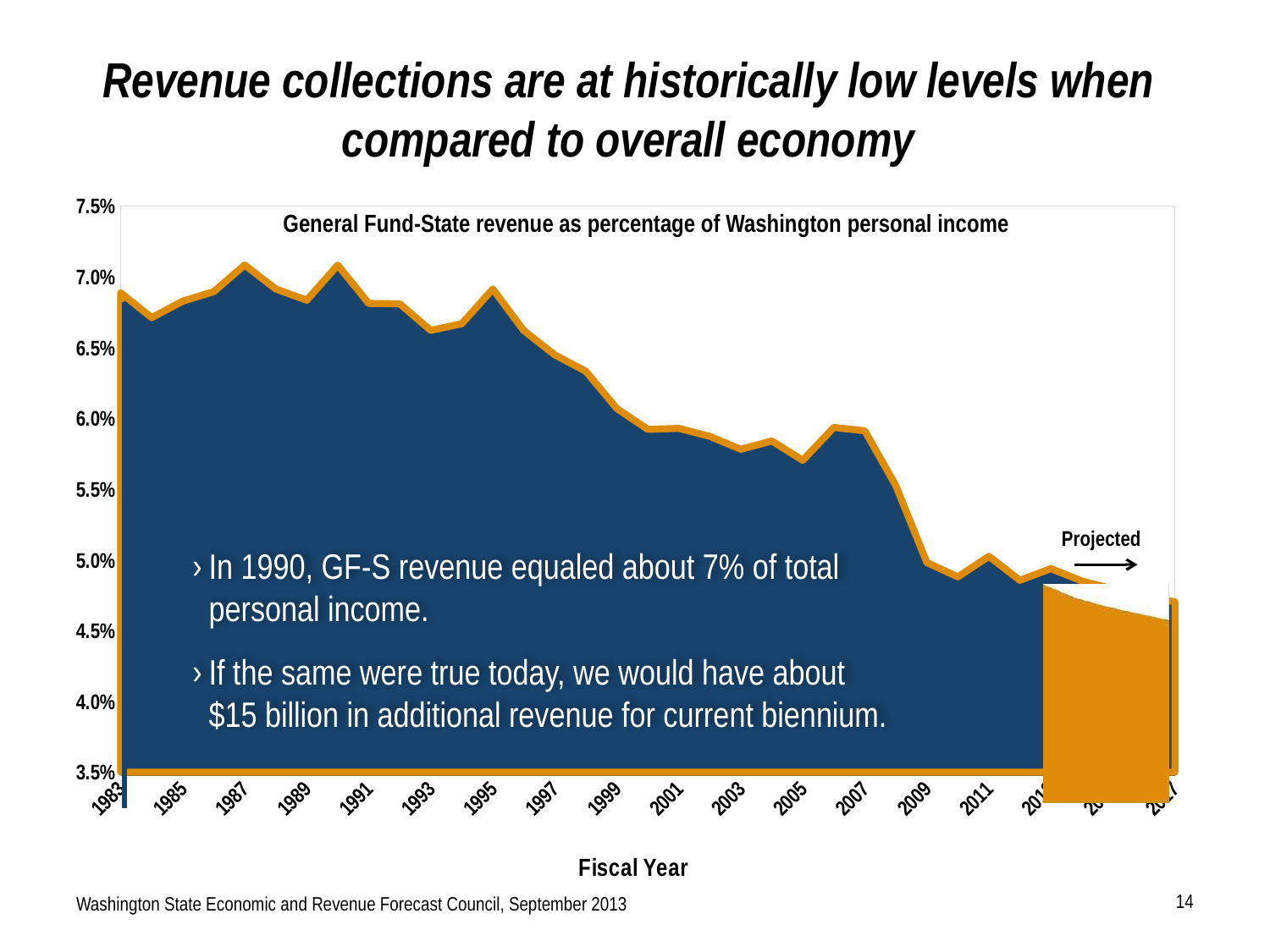
Overall, do the values rise or fall from 1983 to 2017? Fall Is the value for 2017 greater or less than 5.0%? less What is the label of the x axis? Fiscal Year Is the value for 2005 greater or less than 6.0%? less Is the value for 1995 greater or less than 6.5%? greater Which is larger, the value for 1983 or the value for 2013? 1983 Which is larger, the value for 1995 or the value for 2005? 1995 What kind of chart is shown on the slide? Area chart What is the title of the chart? General Fund-State revenue as percentage of Washington personal income